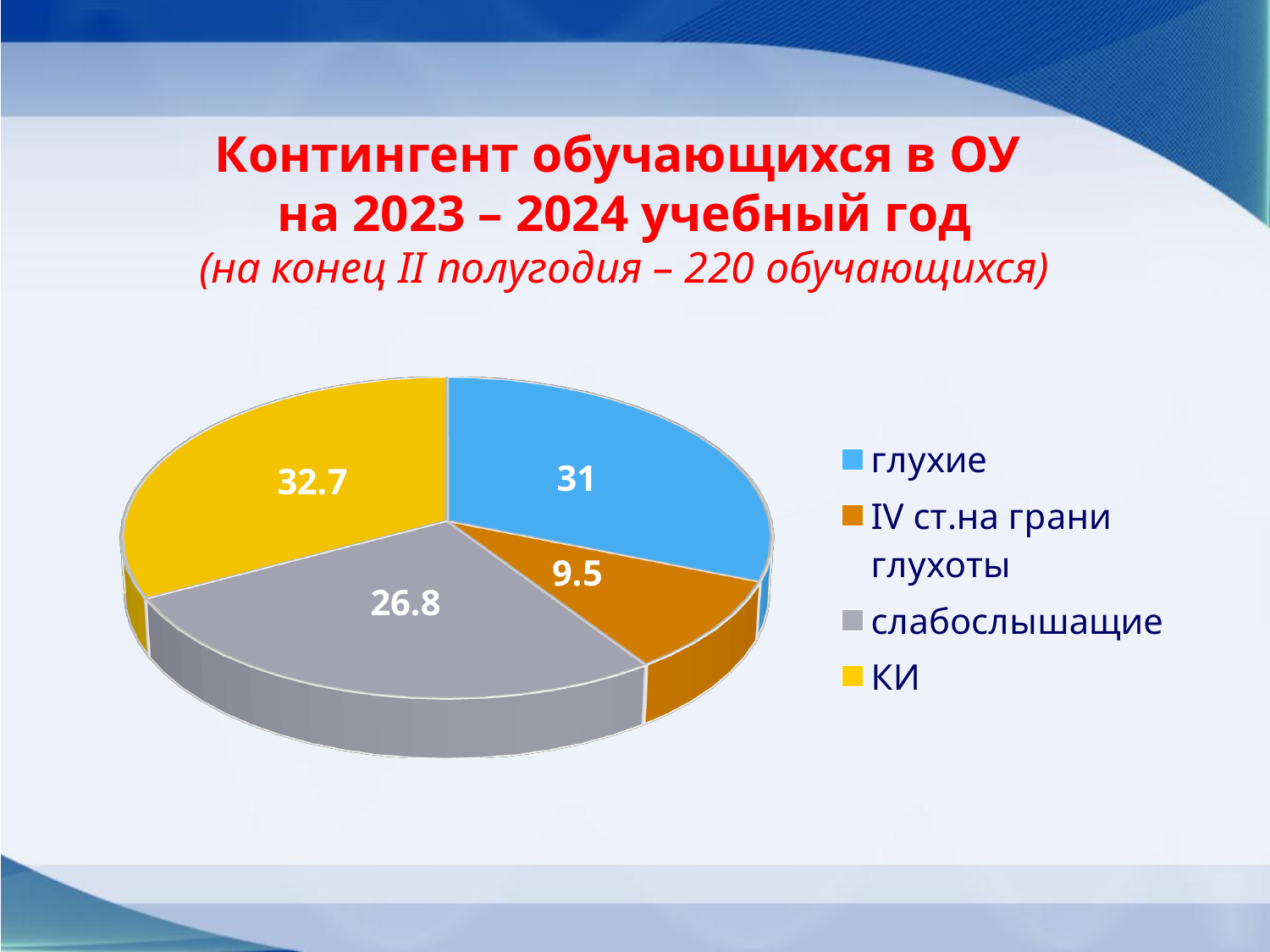
What is the value shown for the "КИ" slice? 32.7 What kind of chart is shown on the slide? pie chart What is the difference between the values for "КИ" and "глухие"? 1.7 How many entries does the legend list? 4 How many slices does the pie chart have? 4 What colour is the "слабослышащие" slice? grey Which category has the largest slice of the pie? КИ Which category has the smallest slice of the pie? IV ст.на грани глухоты What is the value shown for the "слабослышащие" slice? 26.8 What is the value shown for the "IV ст.на грани глухоты" slice? 9.5 Which is larger, the value for "слабослышащие" or the value for "IV ст.на грани глухоты"? слабослышащие What is the value shown for the "глухие" slice? 31